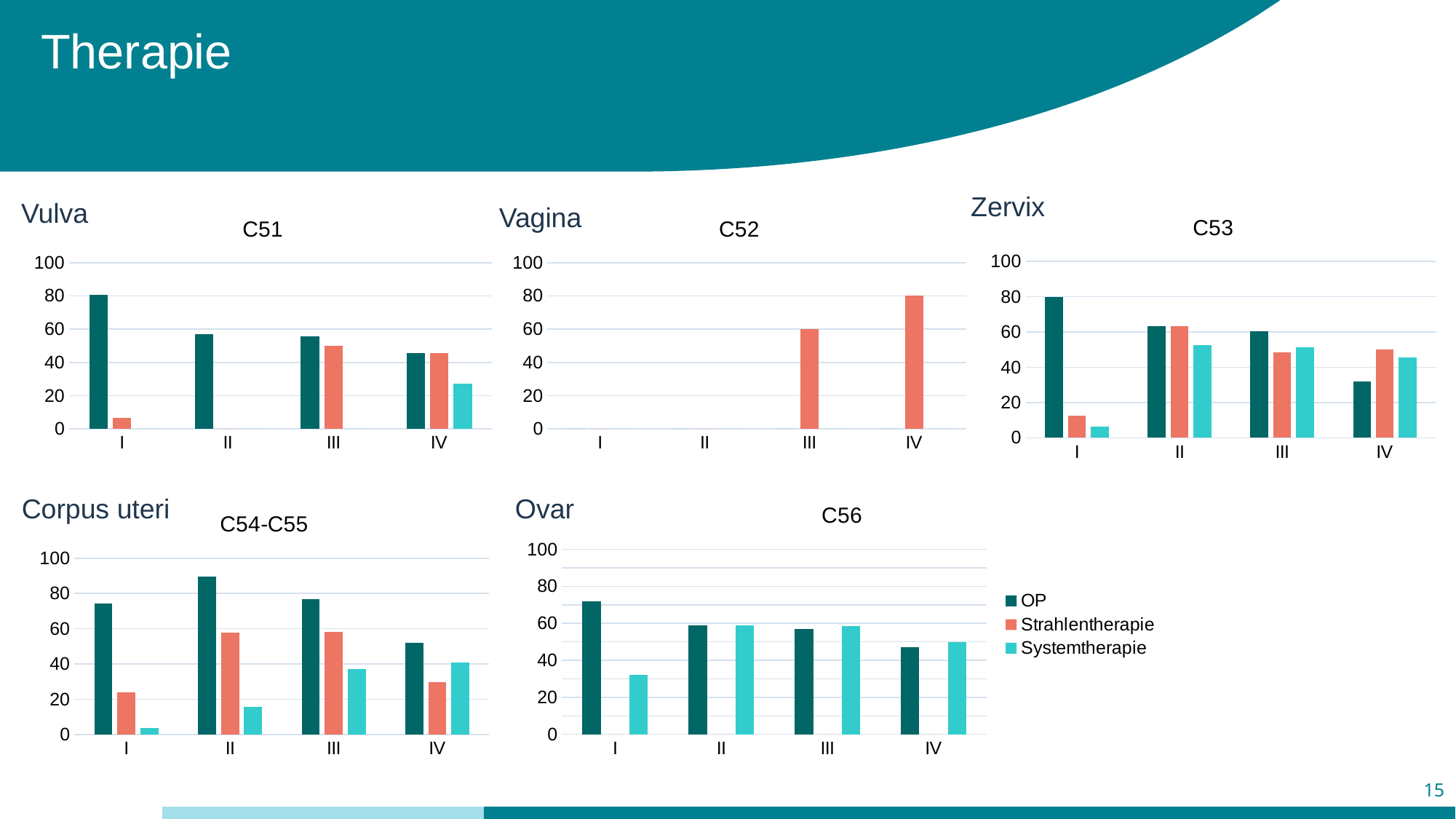
In the C52 chart, what is the value for Strahlentherapie at stage III? 60 In the C53 chart, at which stage is the OP value lowest? IV In the C53 chart, at stage IV, which is larger: OP or Strahlentherapie? Strahlentherapie In the C54-C55 chart, at which stage is the OP value highest? II In the C52 chart, what is the value for Strahlentherapie at stage IV? 80 In the C54-C55 chart, is the OP value at stage II greater or less than 80? greater What kind of chart is the C51 chart? bar chart In the C51 chart, how many categories are shown on the x axis? 4 How many series does the legend list? 3 In the C56 chart, do the OP values rise or fall from stage I to stage IV? fall Which chart title belongs to the Ovar chart? C56 In the C51 chart, is the Strahlentherapie value at stage I greater or less than 20? less